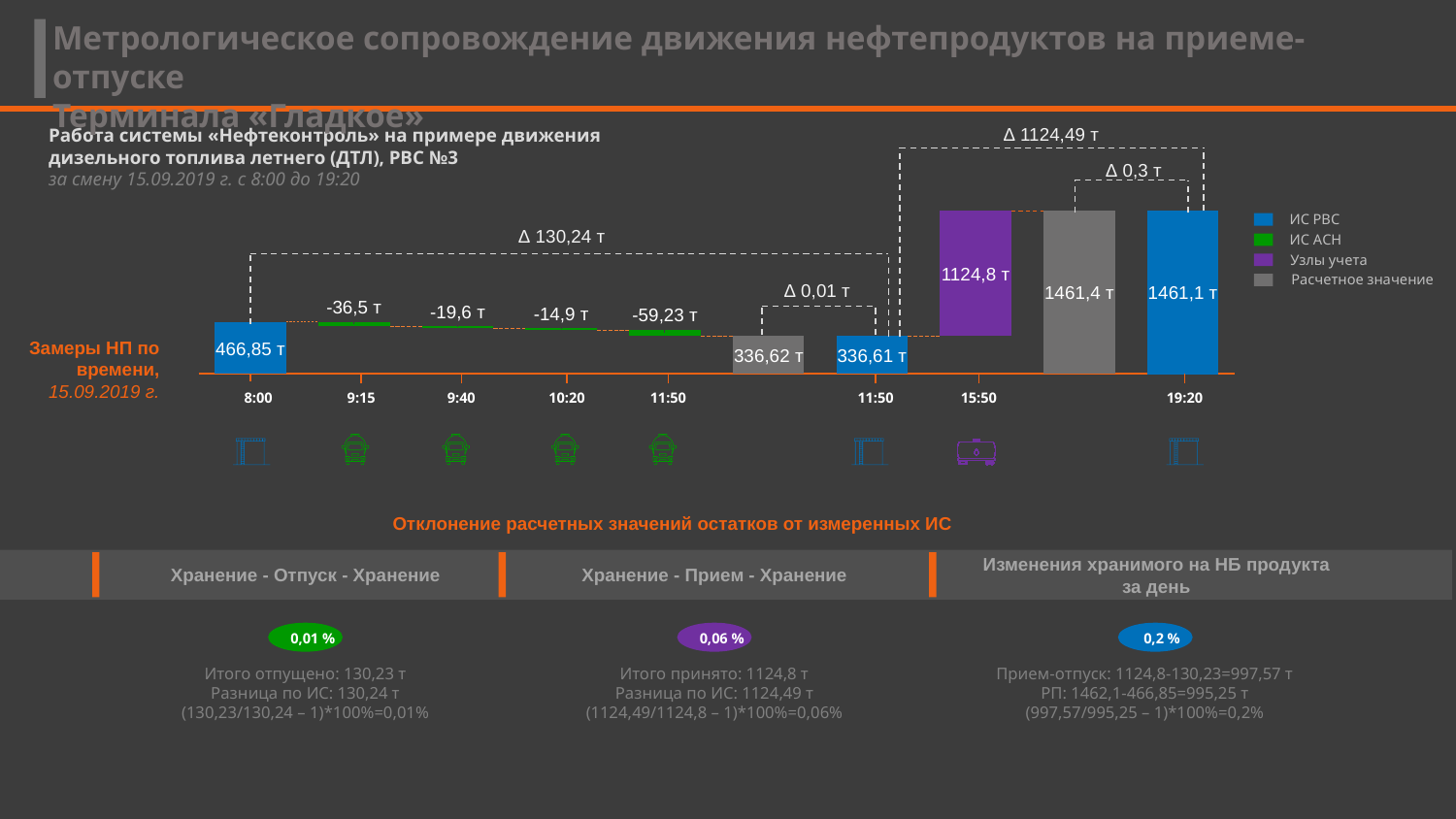
What delta is shown between the 8:00 bar and the 11:50 bar? Δ 130,24 т What is the value of the blue bar at 19:20? 1461,1 т What is the value of the green bar at 9:15? -36,5 т What is the value of the blue bar at 8:00? 466,85 т What is the value of the purple bar at 15:50? 1124,8 т What colour represents 'Узлы учета' in the legend? Purple What is the difference between the blue bar at 19:20 (1461,1 т) and the blue bar at 8:00 (466,85 т)? 994,25 т Which green bar has the largest decrease: 9:15, 9:40, 10:20 or 11:50? 11:50 What is the value of the grey calculated bar next to the blue 336,61 т bar? 336,62 т How many entries does the chart legend list? 4 Which is larger, the grey bar 1461,4 т or the blue bar 1461,1 т? 1461,4 т What delta is shown above the 15:50 purple bar? Δ 1124,49 т